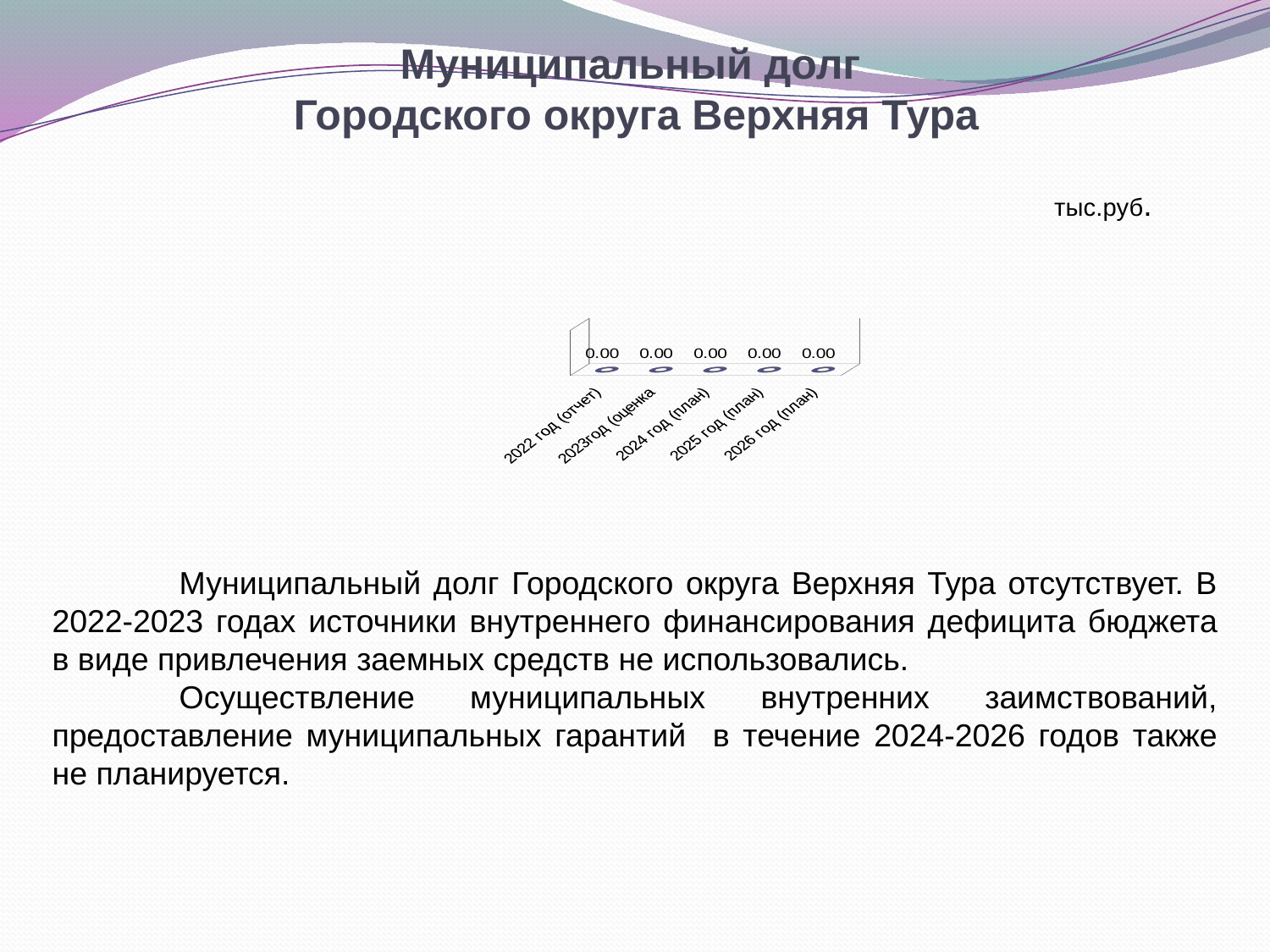
What is the value for 2023год (оценка)? 0.00 What is the value for 2024 год (план)? 0.00 How many categories are shown on the chart? 5 What is the value for 2026 год (план)? 0.00 What is the title of the slide containing the chart? Муниципальный долг Городского округа Верхняя Тура What is the difference between the values for 2022 год (отчет) and 2026 год (план)? 0.00 Do the values rise, fall or stay the same from 2022 год (отчет) to 2026 год (план)? stay the same What is the value for 2025 год (план)? 0.00 What unit is indicated for the chart values? тыс.руб. Is the value for 2024 год (план) larger than, smaller than or equal to the value for 2025 год (план)? equal What is the value for 2022 год (отчет)? 0.00 What kind of chart is shown on the slide? bar chart